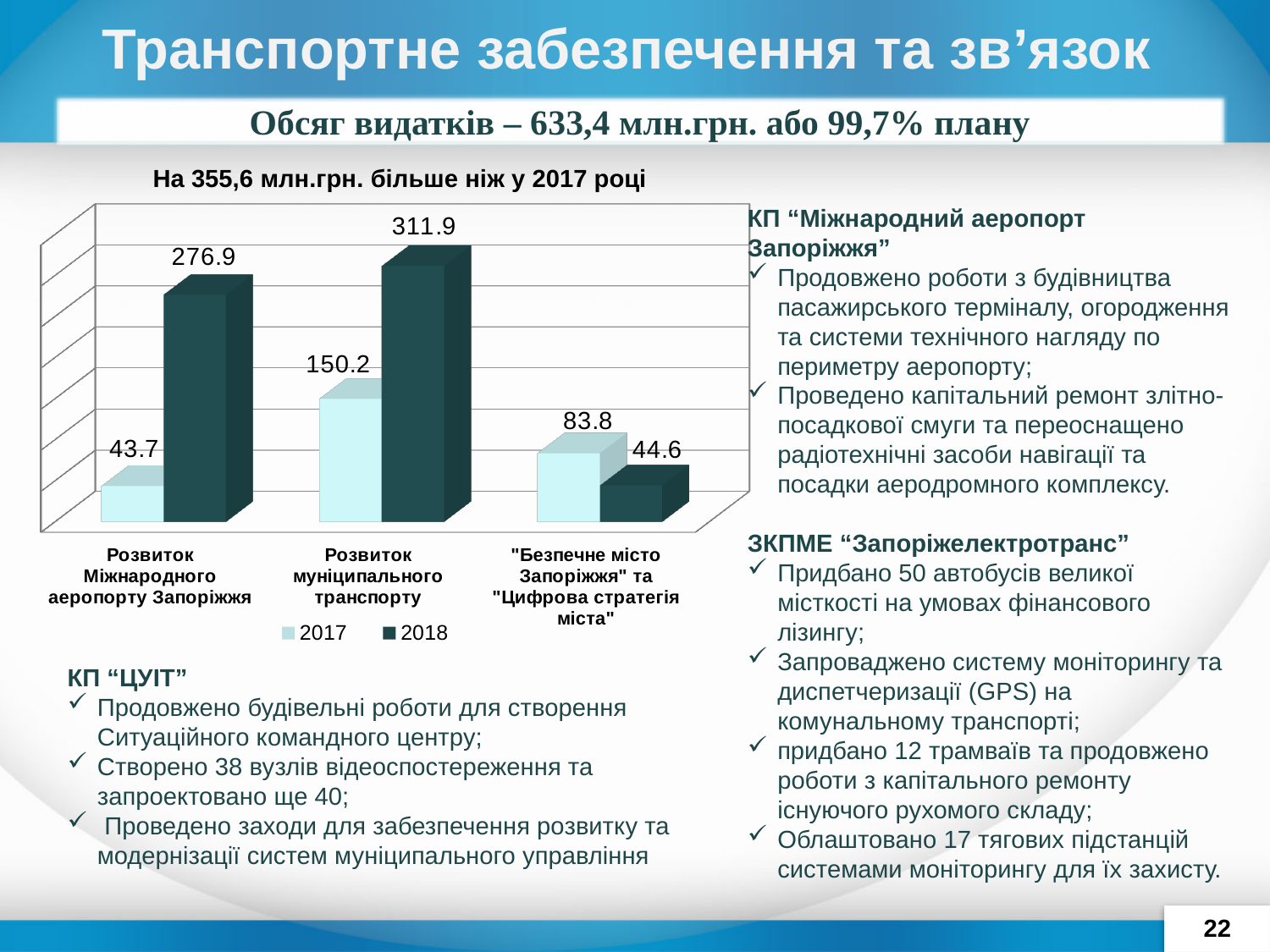
Which category has the highest 2018 value? Розвиток муніципального транспорту What is the 2018 value for Розвиток муніципального транспорту? 311.9 What is the 2017 value for Розвиток Міжнародного аеропорту Запоріжжя? 43.7 What is the 2018 value for "Безпечне місто Запоріжжя" та "Цифрова стратегія міста"? 44.6 For "Безпечне місто Запоріжжя" та "Цифрова стратегія міста", which year has the larger value, 2017 or 2018? 2017 What is the difference between the 2018 and 2017 values for Розвиток Міжнародного аеропорту Запоріжжя? 233.2 Which category has the lowest 2017 value? Розвиток Міжнародного аеропорту Запоріжжя What kind of chart is shown on the slide? Bar chart What is the difference between the 2018 and 2017 values for Розвиток муніципального транспорту? 161.7 How many categories are shown on the x axis of the chart? 3 How many series does the chart legend list? 2 Which series is shown in the darker colour in the chart legend? 2018